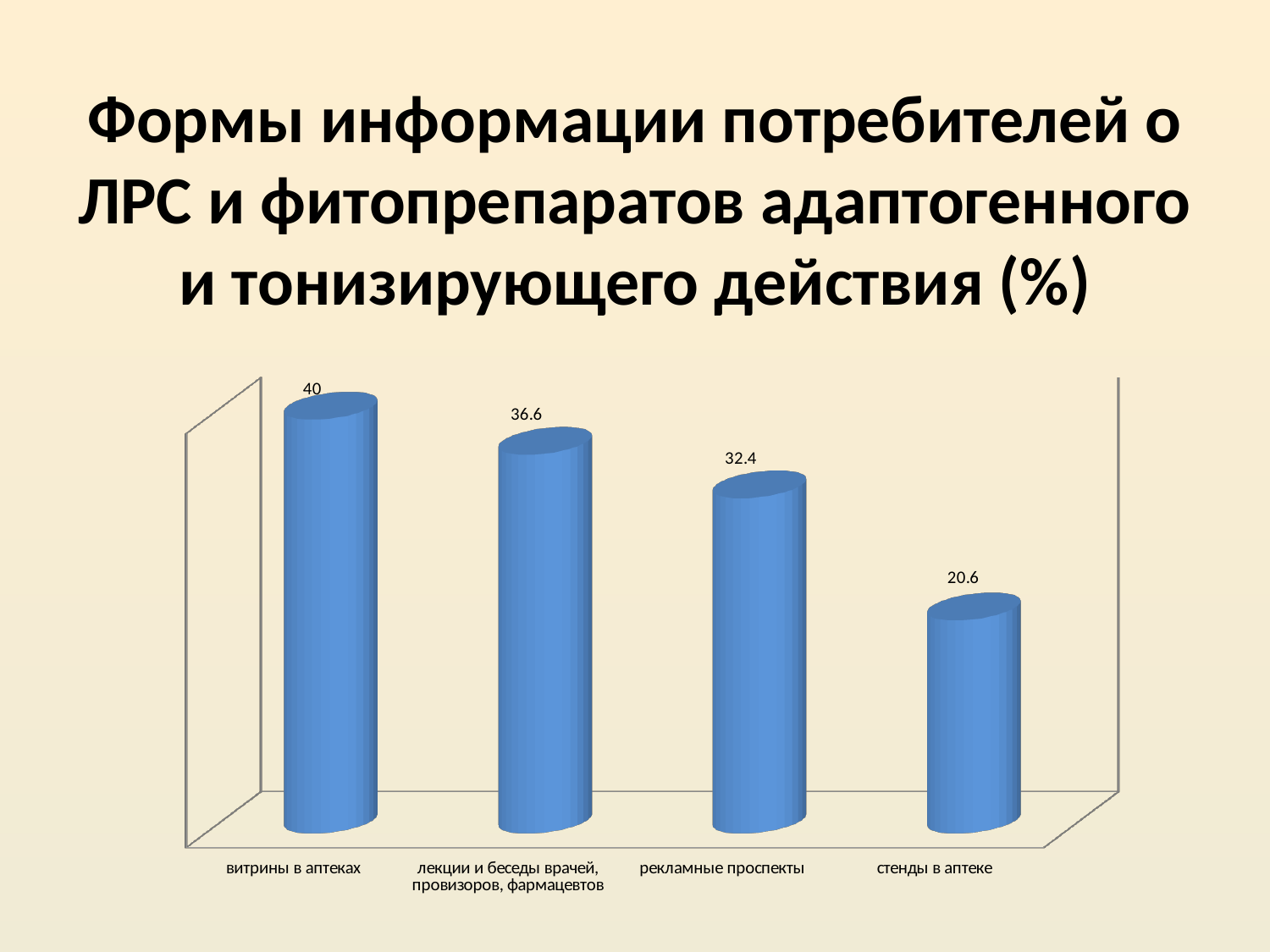
Which category has the lowest value? стенды в аптеке What is the value for витрины в аптеках? 40 How many categories are shown in the chart? 4 What is the value for рекламные проспекты? 32.4 Which category has the highest value? витрины в аптеках What is the value for лекции и беседы врачей, провизоров, фармацевтов? 36.6 Do the values rise or fall from left to right along the x axis? fall Which is larger, the value for рекламные проспекты or the value for стенды в аптеке? рекламные проспекты What is the value for стенды в аптеке? 20.6 What kind of chart is shown on the slide? bar chart What is the difference between the values for витрины в аптеках and стенды в аптеке? 19.4 What is the difference between the values for лекции и беседы врачей, провизоров, фармацевтов and рекламные проспекты? 4.2